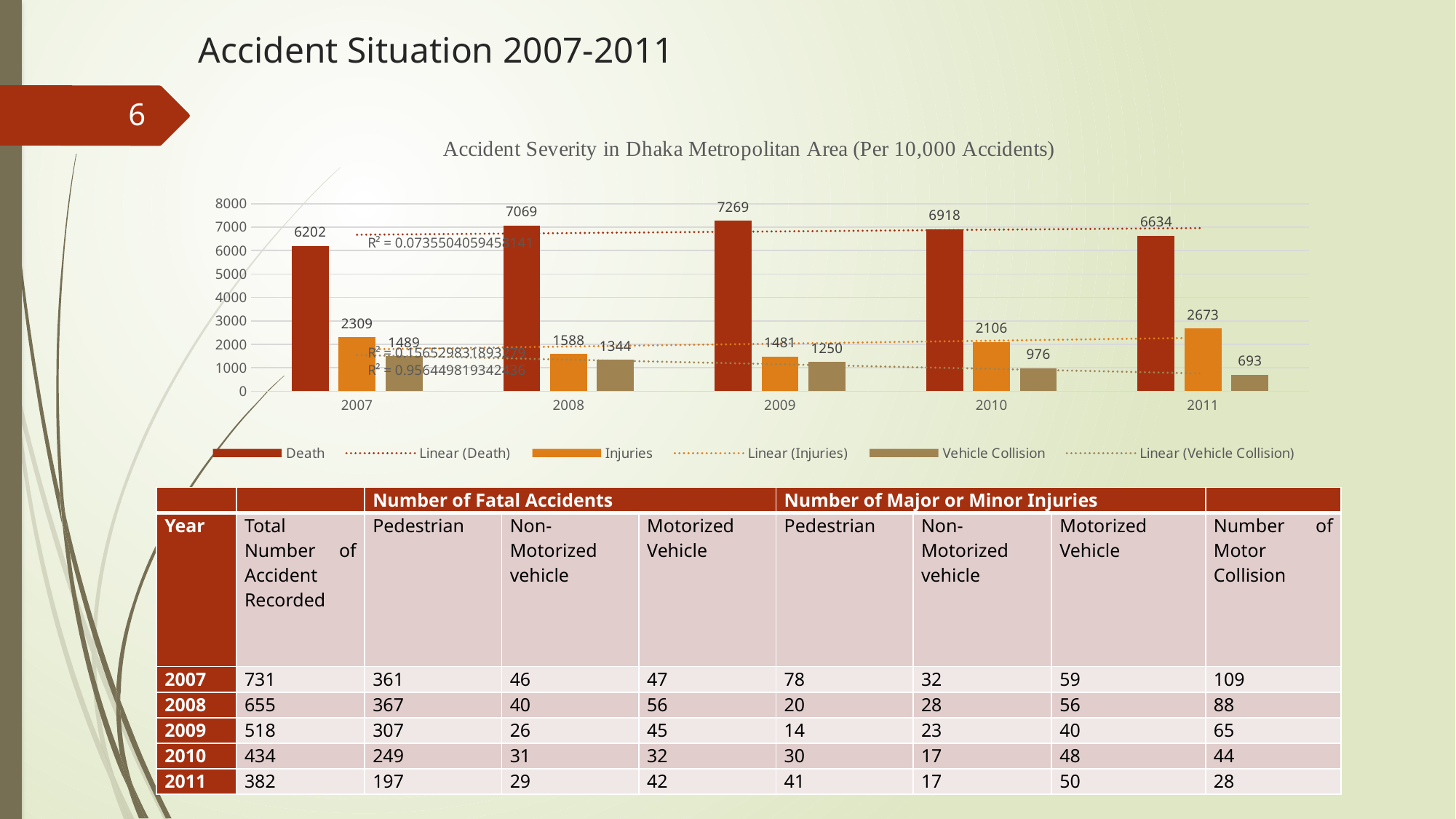
What is the Death value for 2009 in the Accident Severity chart? 7269 In which year is the Death value highest in the Accident Severity chart? 2009 What is the difference between the Death values for 2008 and 2007 in the Accident Severity chart? 867 Is the Death value for 2011 greater or less than 6000 in the Accident Severity chart? greater Which is larger in the Accident Severity chart: Injuries in 2010 or Injuries in 2009? Injuries in 2010 How many years are shown on the x axis of the Accident Severity chart? 5 What is the Vehicle Collision value for 2007 in the Accident Severity chart? 1489 Do the Vehicle Collision values rise or fall from 2007 to 2011 in the Accident Severity chart? fall What is the Injuries value for 2011 in the Accident Severity chart? 2673 How many entries does the legend of the Accident Severity chart list? 6 In which year is the Vehicle Collision value lowest in the Accident Severity chart? 2011 What kind of chart is the Accident Severity in Dhaka Metropolitan Area chart? bar chart